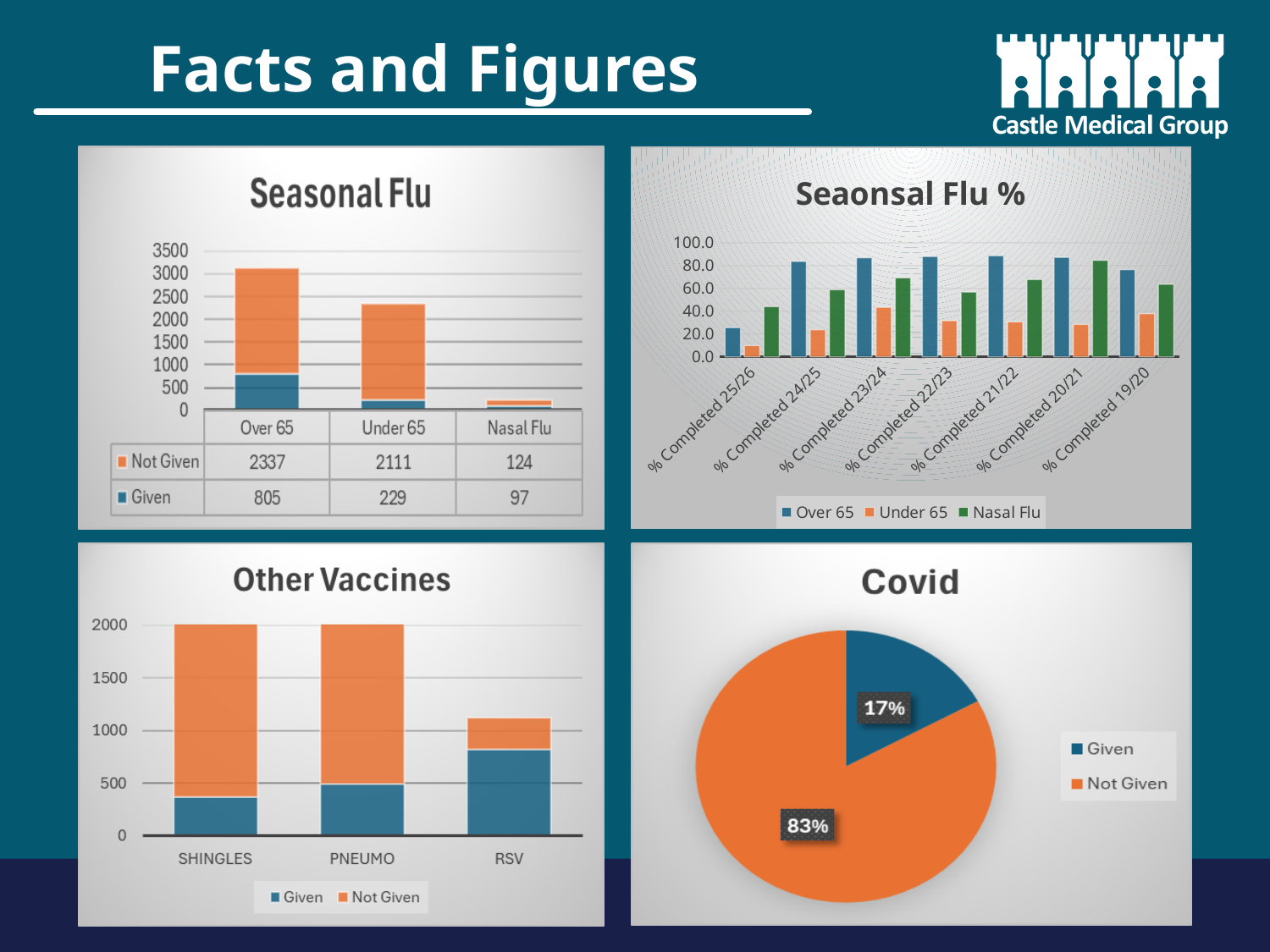
In the Seaonsal Flu % chart, is the Over 65 value for % Completed 25/26 greater or less than 40.0? less How many categories are shown on the x axis of the Seaonsal Flu % chart? 7 In the Seasonal Flu chart, what is the Given value for Under 65? 229 In the Seasonal Flu chart, what is the Not Given value for Over 65? 2337 What kind of chart is the Other Vaccines chart? bar chart How many series does the legend of the Seaonsal Flu % chart list? 3 In the Seasonal Flu chart, which category has the highest Given value? Over 65 In the Covid pie chart, what share is Given? 17% In the Other Vaccines chart, is the Given value for RSV greater or less than 500? greater In the Covid pie chart, which slice is the largest? Not Given In the Seasonal Flu chart, what is the total of the Over 65 stacked bar (Given plus Not Given)? 3142 In the Seasonal Flu chart, what is the difference between the Not Given values for Over 65 and Under 65? 226